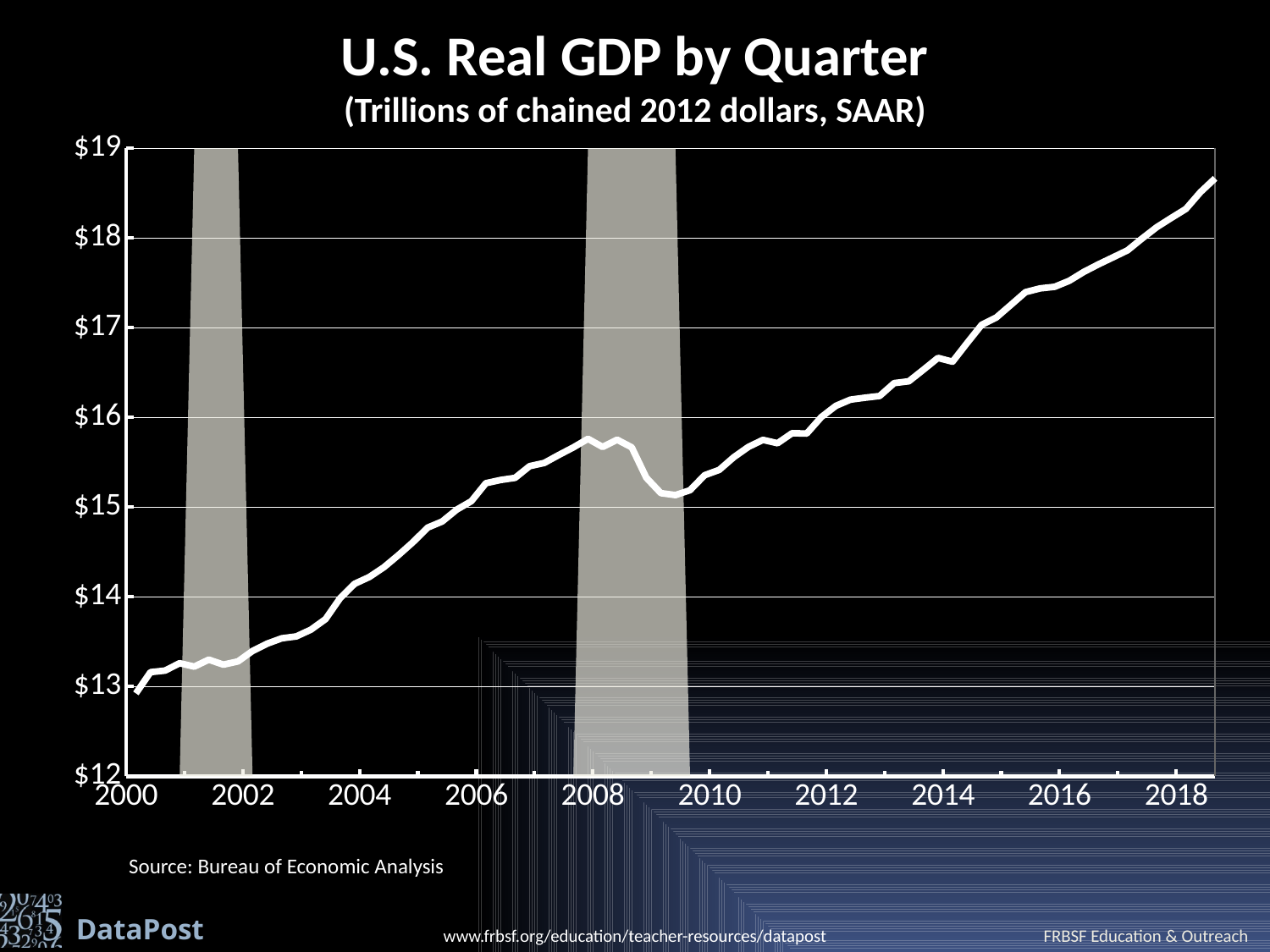
What type of chart is shown on the slide? Line chart Does U.S. real GDP rise or fall between 2008 and 2009? Fall Is the value for 2018 greater or less than $18? greater Which year has the higher real GDP, 2004 or 2012? 2012 What is the title of the chart? U.S. Real GDP by Quarter Is the value for 2002 greater or less than $13? greater Overall, does U.S. real GDP rise or fall from 2000 to 2018? Rise How many shaded vertical bands appear on the chart? 2 Is the value for 2006 greater or less than $15? greater